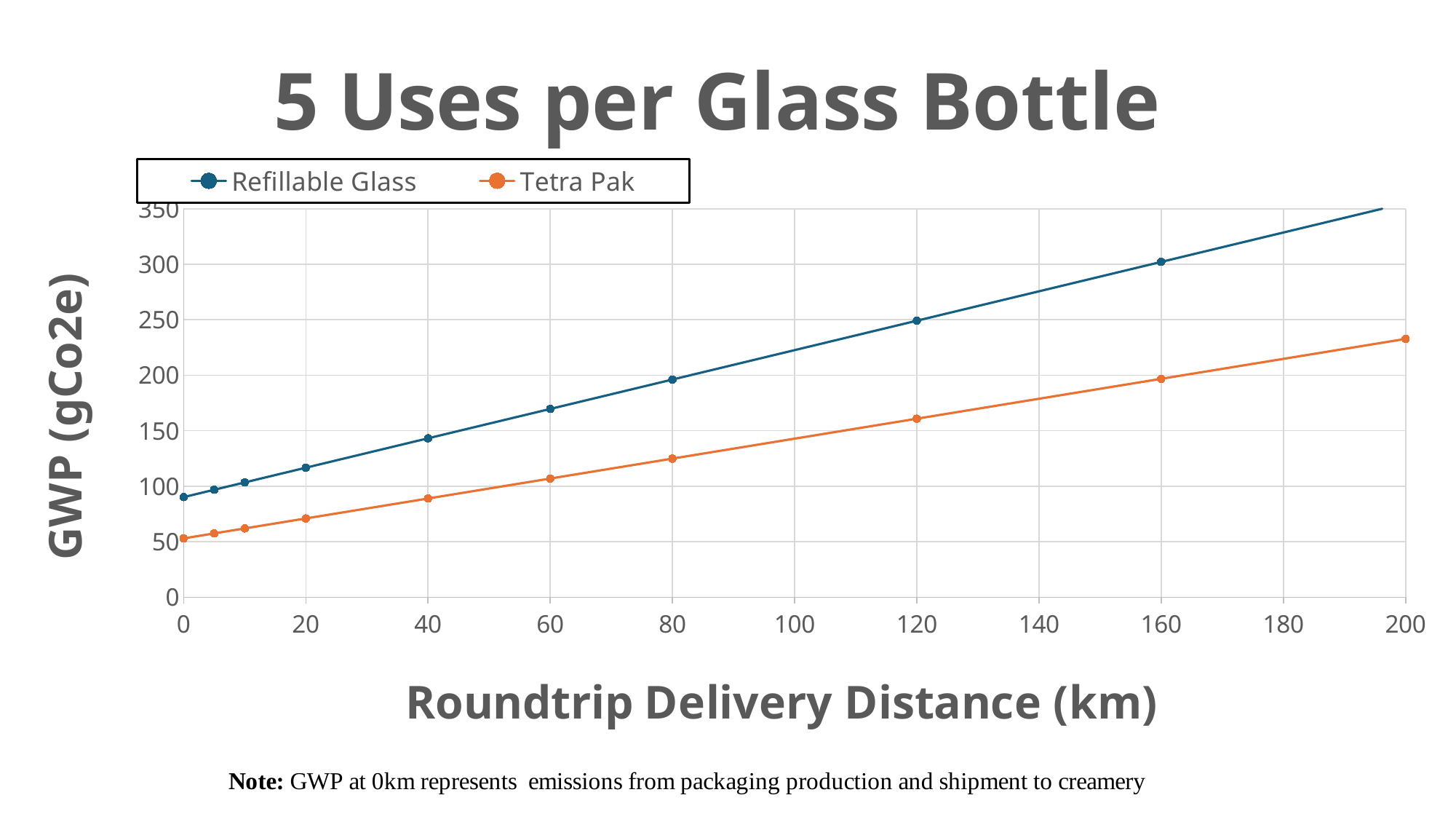
How many data points are plotted for the Tetra Pak series? 10 Is the GWP value for Tetra Pak at 200 km greater or less than 250? less How many series does the legend list? 2 Which series has the lower GWP at 0 km? Tetra Pak What kind of chart is shown on the slide? line chart Which series has the higher GWP at 100 km, Refillable Glass or Tetra Pak? Refillable Glass Is the GWP value for Refillable Glass at 40 km greater or less than 150? less Do the GWP values for Refillable Glass rise or fall as the roundtrip delivery distance increases? rise Is the GWP value for Tetra Pak at 120 km greater or less than 150? greater What is the title of the chart? 5 Uses per Glass Bottle What is the label of the x axis? Roundtrip Delivery Distance (km)